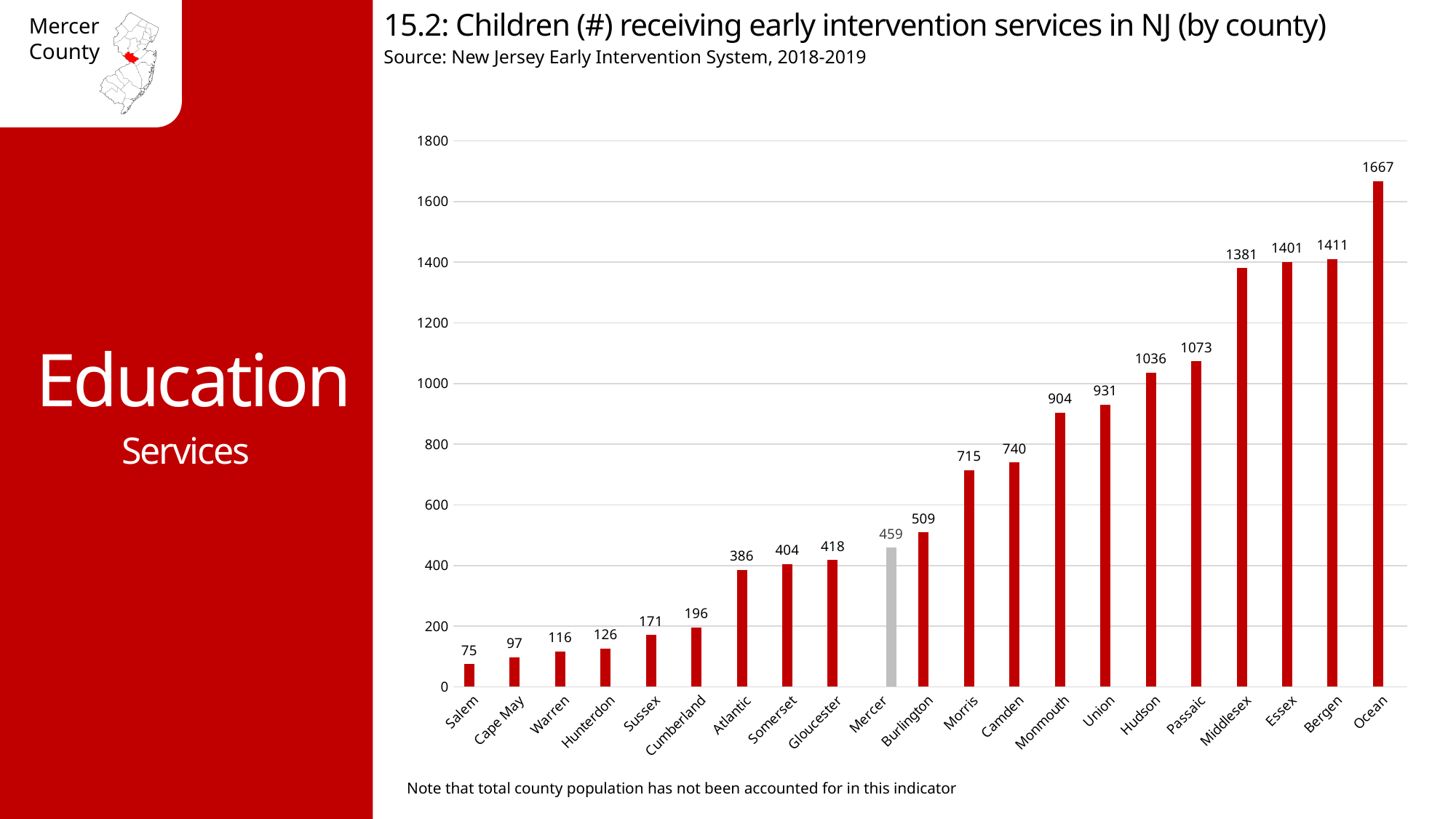
What kind of chart is shown on the slide? Bar chart How many children received early intervention services in Mercer County? 459 What is the value shown for Hudson County? 1036 Do the values rise or fall moving from left to right along the x axis? Rise Is the value for Passaic greater or less than 1000? greater Which has a larger value, Monmouth or Camden? Monmouth What is the difference between the values for Ocean and Bergen? 256 Which county's bar is coloured grey instead of red? Mercer What is the difference between the values for Burlington and Mercer? 50 Which county has the lowest number of children receiving early intervention services? Salem How many counties are shown on the chart? 21 Which county has the highest number of children receiving early intervention services? Ocean